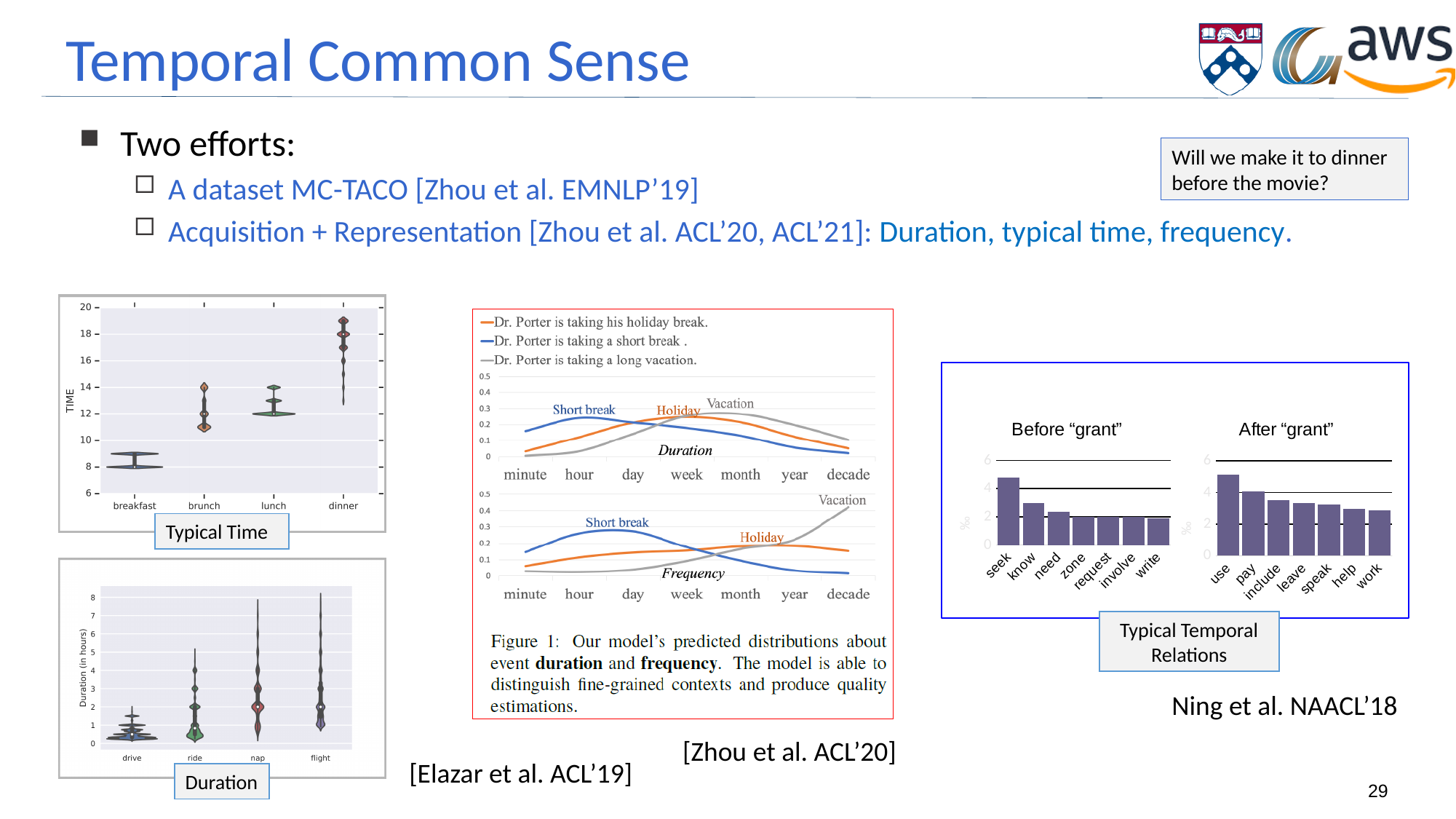
In the Zhou et al. ACL'20 figure, how many sentences (series) does the legend list? 3 In the "Duration" chart, what is the label of the y axis? Duration (in hours) In the Before "grant" chart, is the value for "know" greater or less than 4? less In the "Typical Time" chart, which meal has the lowest typical time? breakfast In the "Typical Time" chart, how many meal categories are shown on the x axis? 4 In the "Typical Time" chart, which meal has the highest typical time? dinner In the Zhou et al. ACL'20 figure, what kind of chart is used to show the predicted distributions? line chart In the Frequency panel of the Zhou et al. ACL'20 figure, does the Vacation curve rise or fall from year to decade? rise In the "Duration" chart, what are the four activity categories on the x axis? drive, ride, nap, flight In the Zhou et al. ACL'20 figure, how many time units are shown along the x axis of each panel? 7 In the After "grant" chart, which word has the highest bar? use In the Before "grant" chart, which word has the highest bar? seek